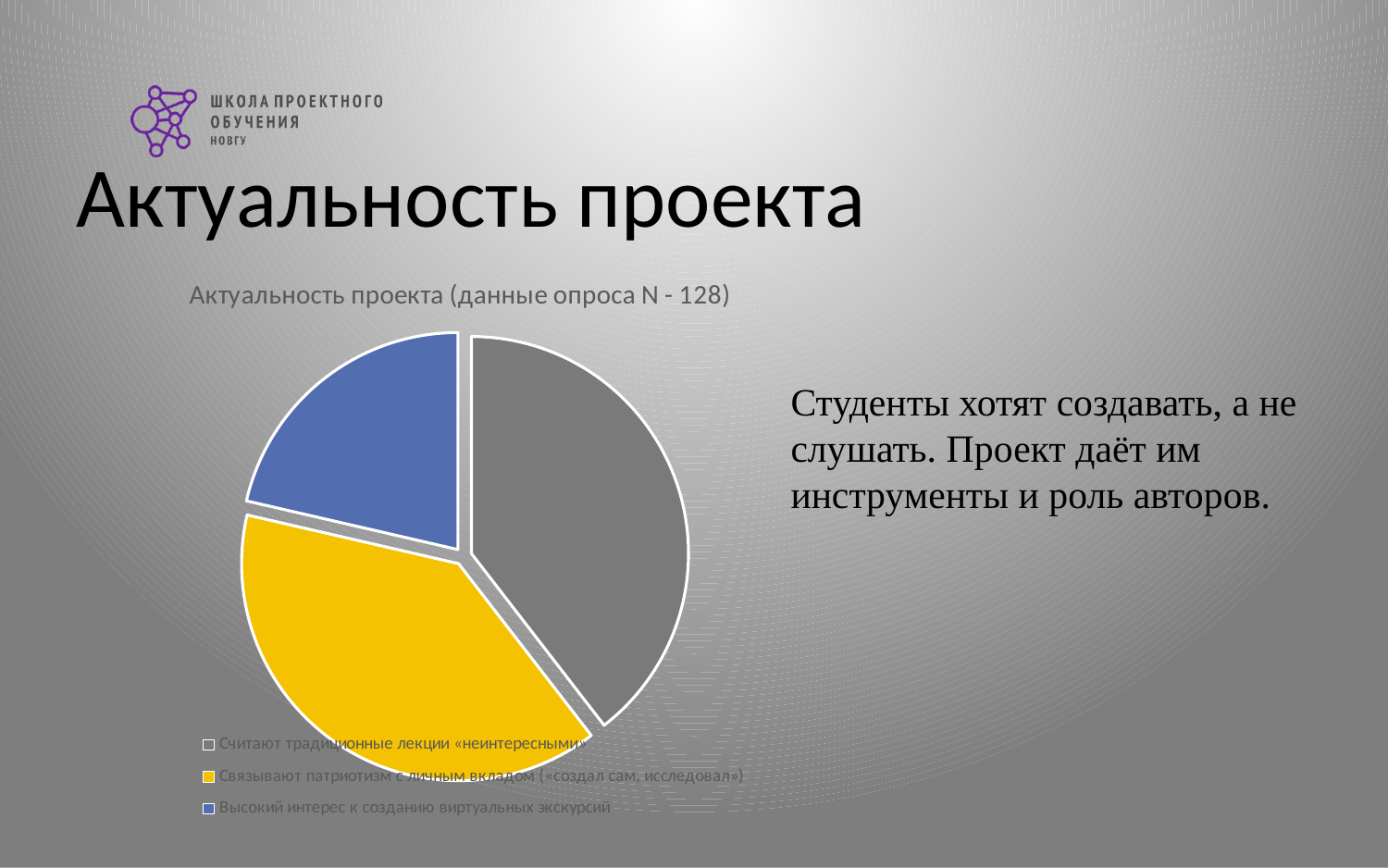
Which slice is larger: «Считают традиционные лекции «неинтересными»» or «Высокий интерес к созданию виртуальных экскурсий»? Считают традиционные лекции «неинтересными» How many slices does the pie chart have? 3 What colour is the slice for «Связывают патриотизм с личным вкладом («создал сам, исследовал»)»? yellow Which slice is larger: «Связывают патриотизм с личным вкладом («создал сам, исследовал»)» or «Высокий интерес к созданию виртуальных экскурсий»? Связывают патриотизм с личным вкладом («создал сам, исследовал») What kind of chart is shown on the slide? pie chart Which category has the smallest slice in the pie chart? Высокий интерес к созданию виртуальных экскурсий What is the title of the pie chart? Актуальность проекта (данные опроса N - 128) How many entries does the legend of the pie chart list? 3